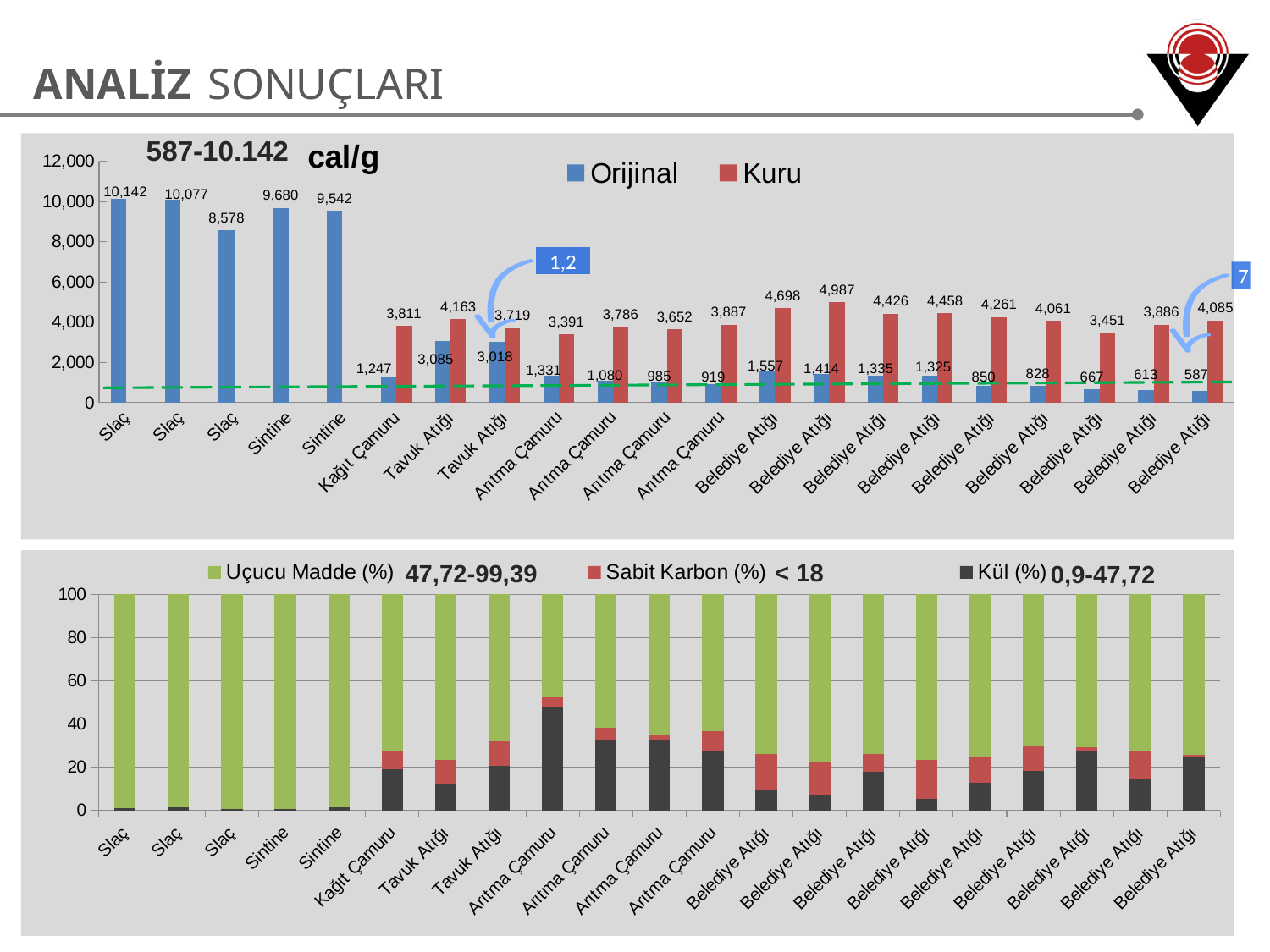
In the top chart, what is the Kuru value for Kağıt Çamuru? 3,811 How many categories are plotted along the x axis of the top chart? 21 How many series does the legend of the top chart list? 2 What kind of chart is the top chart (Orijinal / Kuru)? bar chart In the top chart, what is the Kuru value for the first Tavuk Atığı bar? 4,163 In the top chart, what is the difference between the Kuru and Orijinal values for Kağıt Çamuru? 2,564 In the bottom chart, is the Kül (%) value for the first Arıtma Çamuru bar greater or less than 40? greater In the top chart, what is the highest Orijinal value shown? 10,142 In the top chart, what is the lowest Orijinal value shown? 587 In the top chart, what is the highest Kuru value shown? 4,987 How many series does the legend of the bottom chart list? 3 In the top chart, what is the Orijinal value for Kağıt Çamuru? 1,247